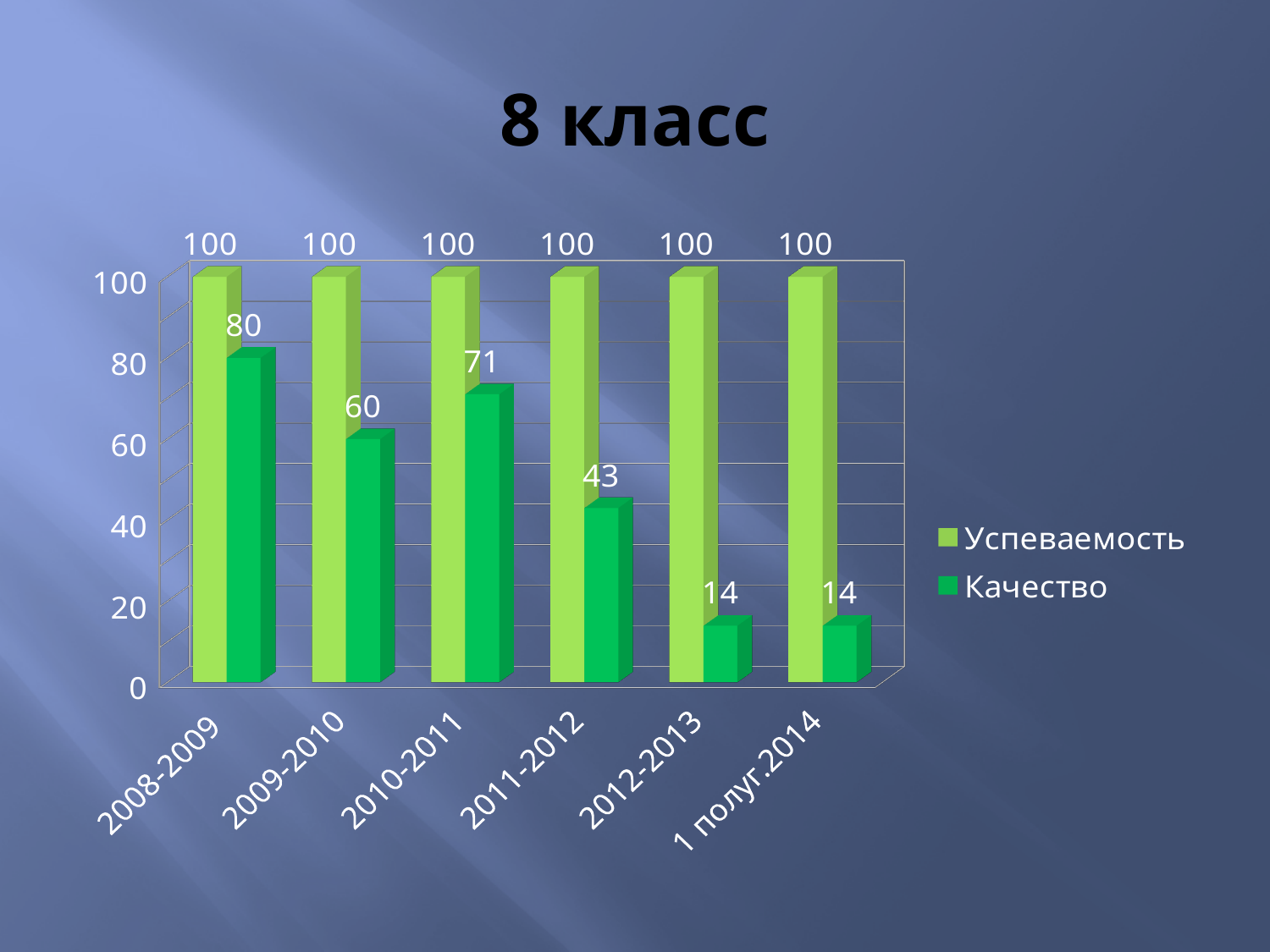
What is the value of Качество for 2011-2012? 43 What is the difference between Успеваемость and Качество for 2009-2010? 40 What is the difference between the Качество values for 2010-2011 and 2011-2012? 28 Which is larger, the Качество value for 2009-2010 or for 2010-2011? 2010-2011 What is the value of Успеваемость for 2010-2011? 100 How many categories are shown on the x axis? 6 Does the Качество series rise or fall from 2008-2009 to 2012-2013? fall What is the value of Качество for 2008-2009? 80 How many series does the legend list? 2 What kind of chart is shown on the slide? bar chart What is the value of Качество for 1 полуг.2014? 14 Which category has the highest Качество value? 2008-2009